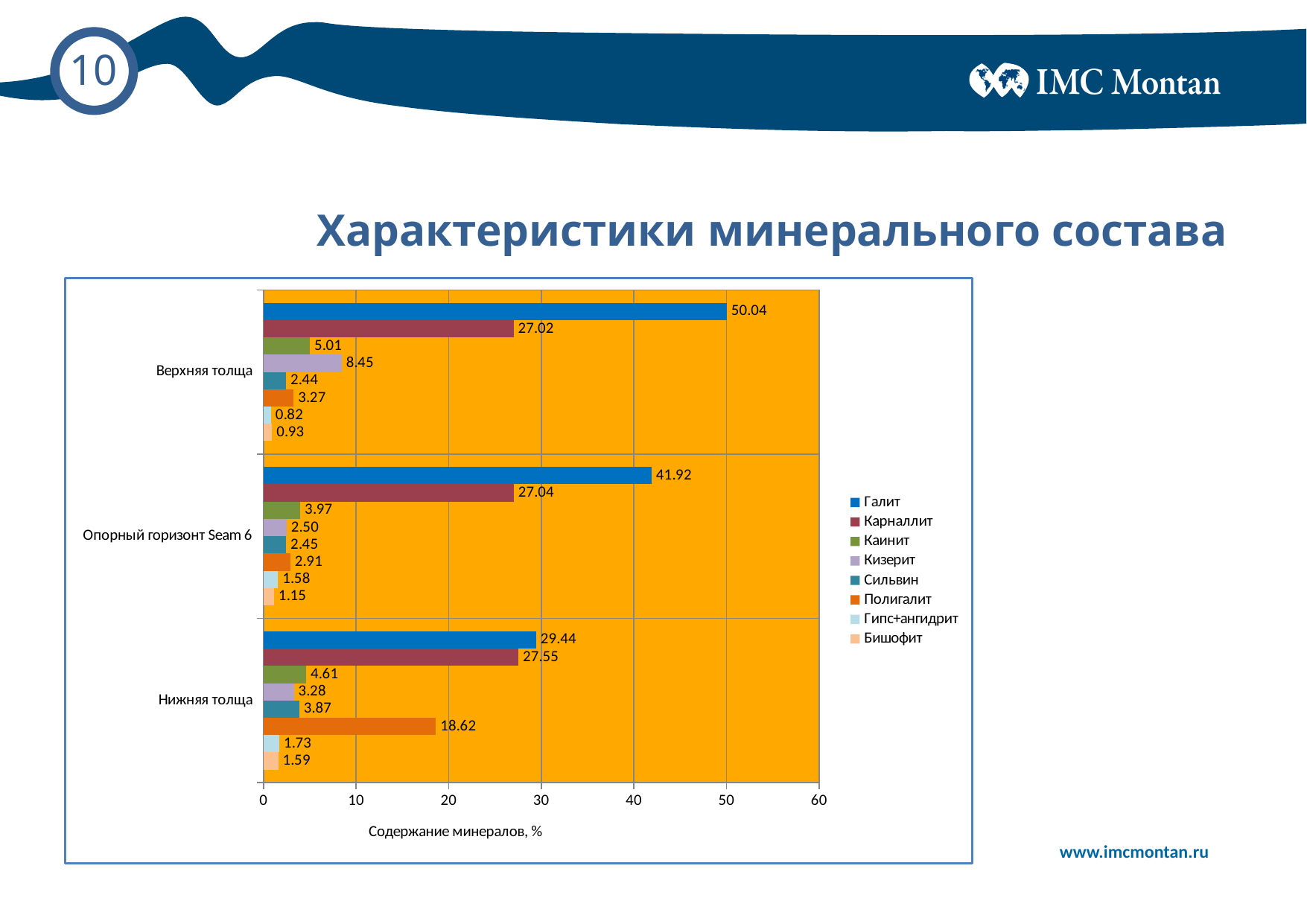
What is the label of the horizontal axis? Содержание минералов, % Which is larger: Каинит in Верхняя толща or Каинит in Нижняя толща? Каинит in Верхняя толща Which series has the lowest value in Верхняя толща? Гипс+ангидрит What is the difference between the Галит values for Верхняя толща and Нижняя толща? 20.60 Which category has the highest value for Галит? Верхняя толща Is the value for Галит in Опорный горизонт Seam 6 greater or less than 40? greater How many series does the legend list? 8 What is the value for Галит in Верхняя толща? 50.04 How many categories are shown on the vertical axis? 3 What kind of chart is shown on the slide? Bar chart What is the value for Кизерит in Опорный горизонт Seam 6? 2.50 What is the value for Полигалит in Нижняя толща? 18.62